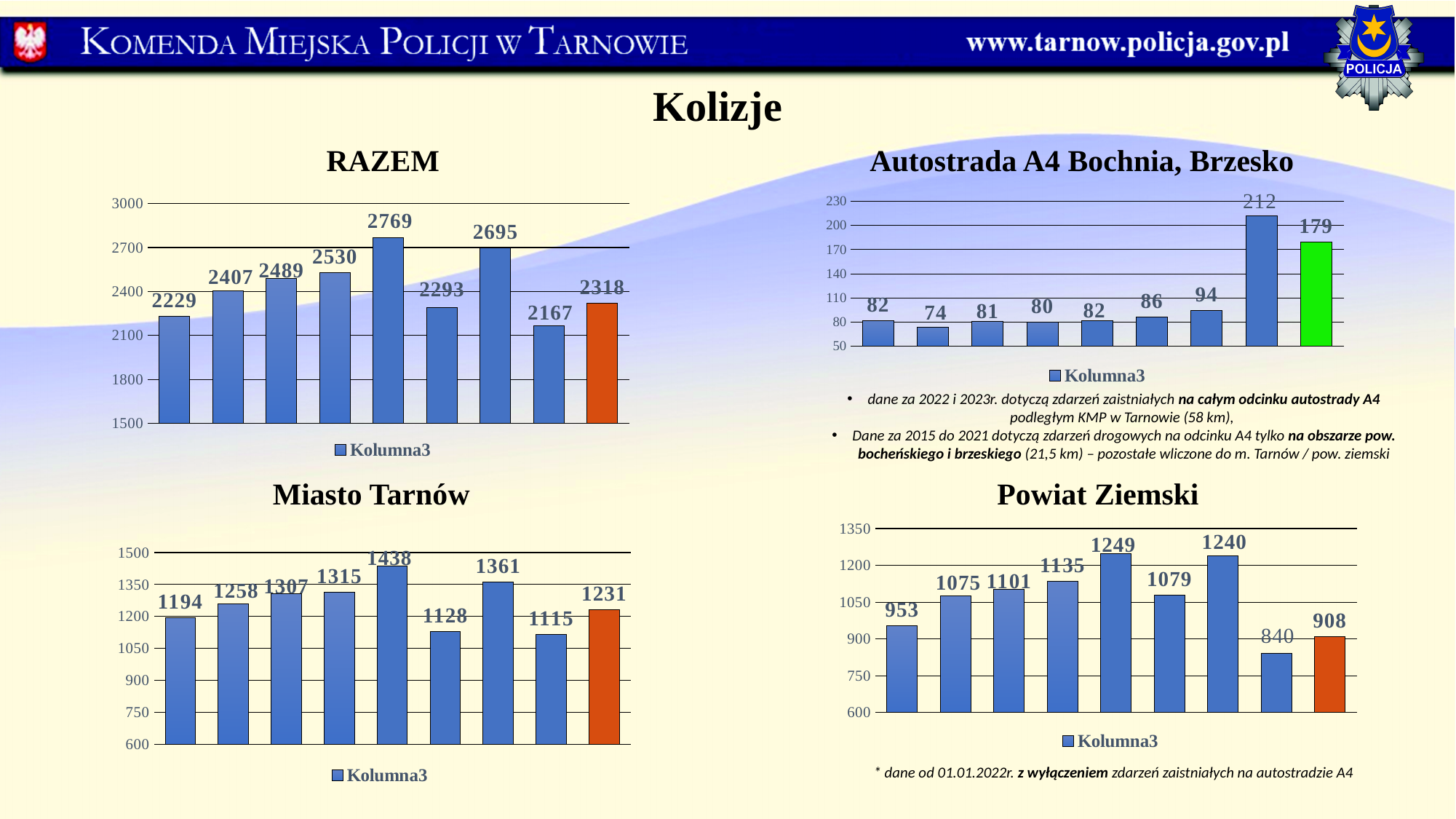
In the RAZEM chart, what value is labelled on the orange bar at the far right? 2318 In the Miasto Tarnów chart, what is the lowest value shown? 1115 In the Autostrada A4 Bochnia, Brzesko chart, what value is labelled on the green bar? 179 In the Powiat Ziemski chart, what is the difference between the orange bar (908) and the bar immediately to its left (840)? 68 In the Autostrada A4 Bochnia, Brzesko chart, what is the difference between the tallest bar (212) and the green bar (179)? 33 In the Miasto Tarnów chart, what is the highest value shown? 1438 In the Autostrada A4 Bochnia, Brzesko chart, what is the highest value shown? 212 In the Powiat Ziemski chart, what is the lowest value shown? 840 What type of chart is the Powiat Ziemski chart? Bar chart In the RAZEM chart, what is the highest value shown? 2769 How many bars are plotted in the RAZEM chart? 9 In the RAZEM chart, what is the lowest value shown? 2167